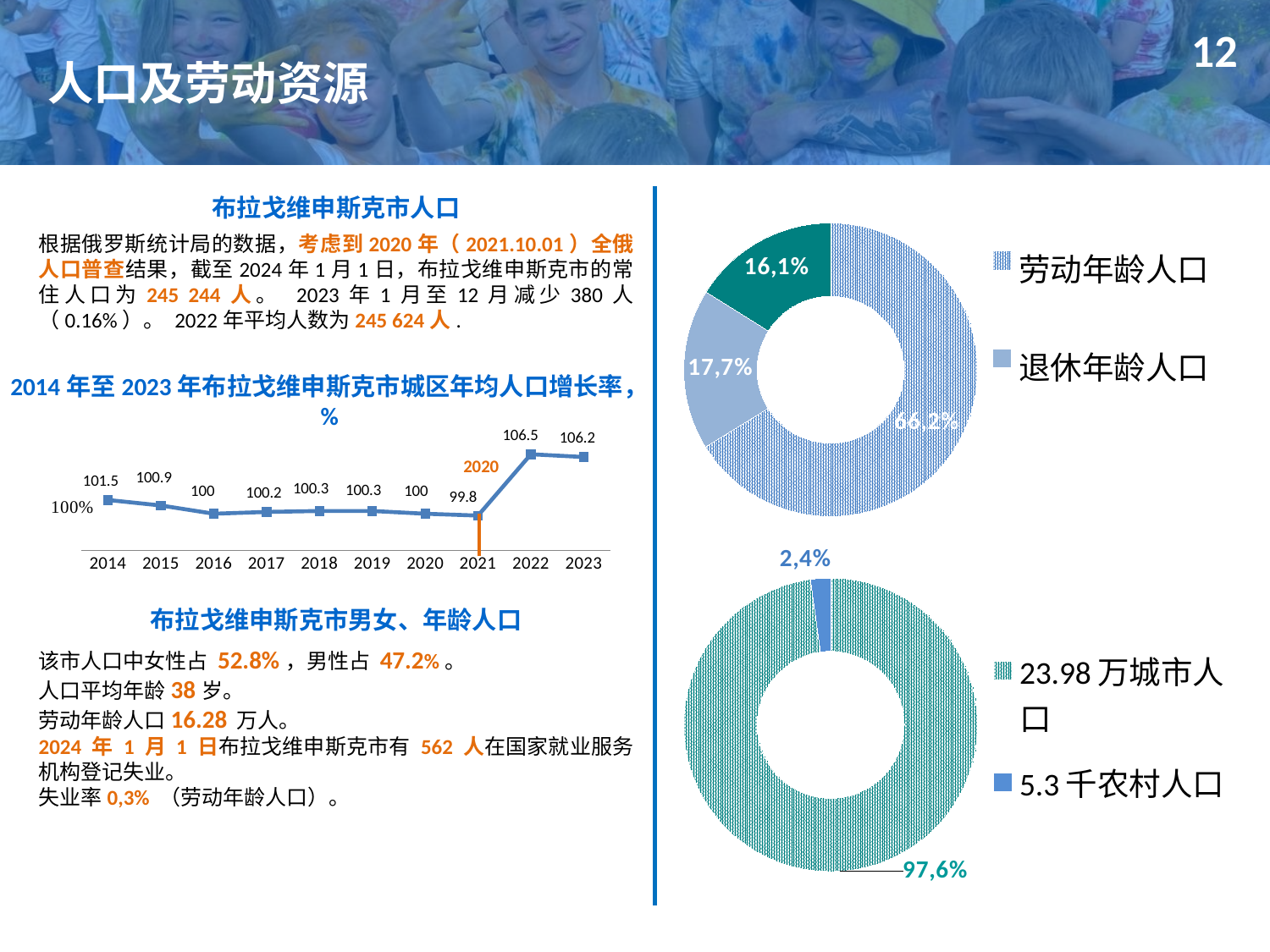
In the bottom doughnut chart on the right, how many entries does the legend list? 2 In the line chart titled 2014年至2023年布拉戈维申斯克市城区年均人口增长率, is the value for 2014 larger or smaller than the value for 2015? larger In the top doughnut chart on the right, what share is shown for 劳动年龄人口? 66,2% In the bottom doughnut chart on the right, what share is shown for 5.3千农村人口? 2,4% In the line chart titled 2014年至2023年布拉戈维申斯克市城区年均人口增长率, what is the value for 2022? 106.5 In the line chart titled 2014年至2023年布拉戈维申斯克市城区年均人口增长率, what is the value for 2021? 99.8 In the line chart titled 2014年至2023年布拉戈维申斯克市城区年均人口增长率, which year has the lowest value? 2021 What kind of chart is the chart titled 2014年至2023年布拉戈维申斯克市城区年均人口增长率? line chart In the top doughnut chart on the right, what share is shown for 退休年龄人口? 17,7% In the line chart titled 2014年至2023年布拉戈维申斯克市城区年均人口增长率, how many years are plotted? 10 In the line chart titled 2014年至2023年布拉戈维申斯克市城区年均人口增长率, what is the difference between the 2022 value and the 2021 value? 6.7 In the line chart titled 2014年至2023年布拉戈维申斯克市城区年均人口增长率, which year has the highest value? 2022